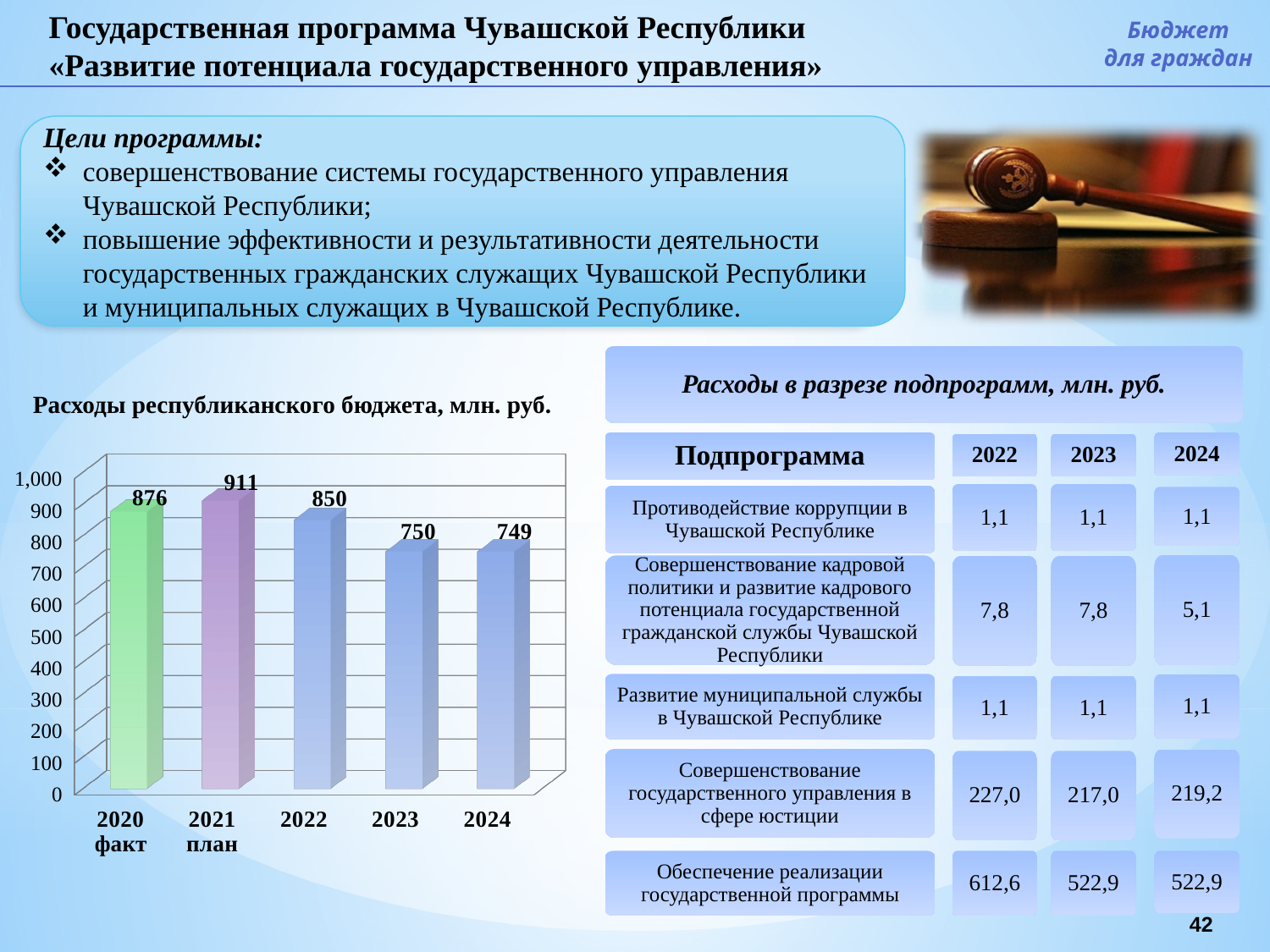
Is the value for 2022 in the chart 'Расходы республиканского бюджета, млн. руб.' greater or less than 800? greater What is the value for 2021 план in the chart 'Расходы республиканского бюджета, млн. руб.'? 911 What is the value for 2020 факт in the chart 'Расходы республиканского бюджета, млн. руб.'? 876 What is the value for 2023 in the chart 'Расходы республиканского бюджета, млн. руб.'? 750 What is the difference between the values for 2021 план and 2022 in the chart 'Расходы республиканского бюджета, млн. руб.'? 61 Which year has the lowest value in the chart 'Расходы республиканского бюджета, млн. руб.'? 2024 How many years (categories) are shown in the chart 'Расходы республиканского бюджета, млн. руб.'? 5 What is the difference between the values for 2020 факт and 2023 in the chart 'Расходы республиканского бюджета, млн. руб.'? 126 Which year has the highest value in the chart 'Расходы республиканского бюджета, млн. руб.'? 2021 план What kind of chart is 'Расходы республиканского бюджета, млн. руб.'? bar chart Do the values in the chart 'Расходы республиканского бюджета, млн. руб.' rise or fall from 2021 план to 2024? fall Which is larger in the chart 'Расходы республиканского бюджета, млн. руб.': the value for 2020 факт or the value for 2022? 2020 факт